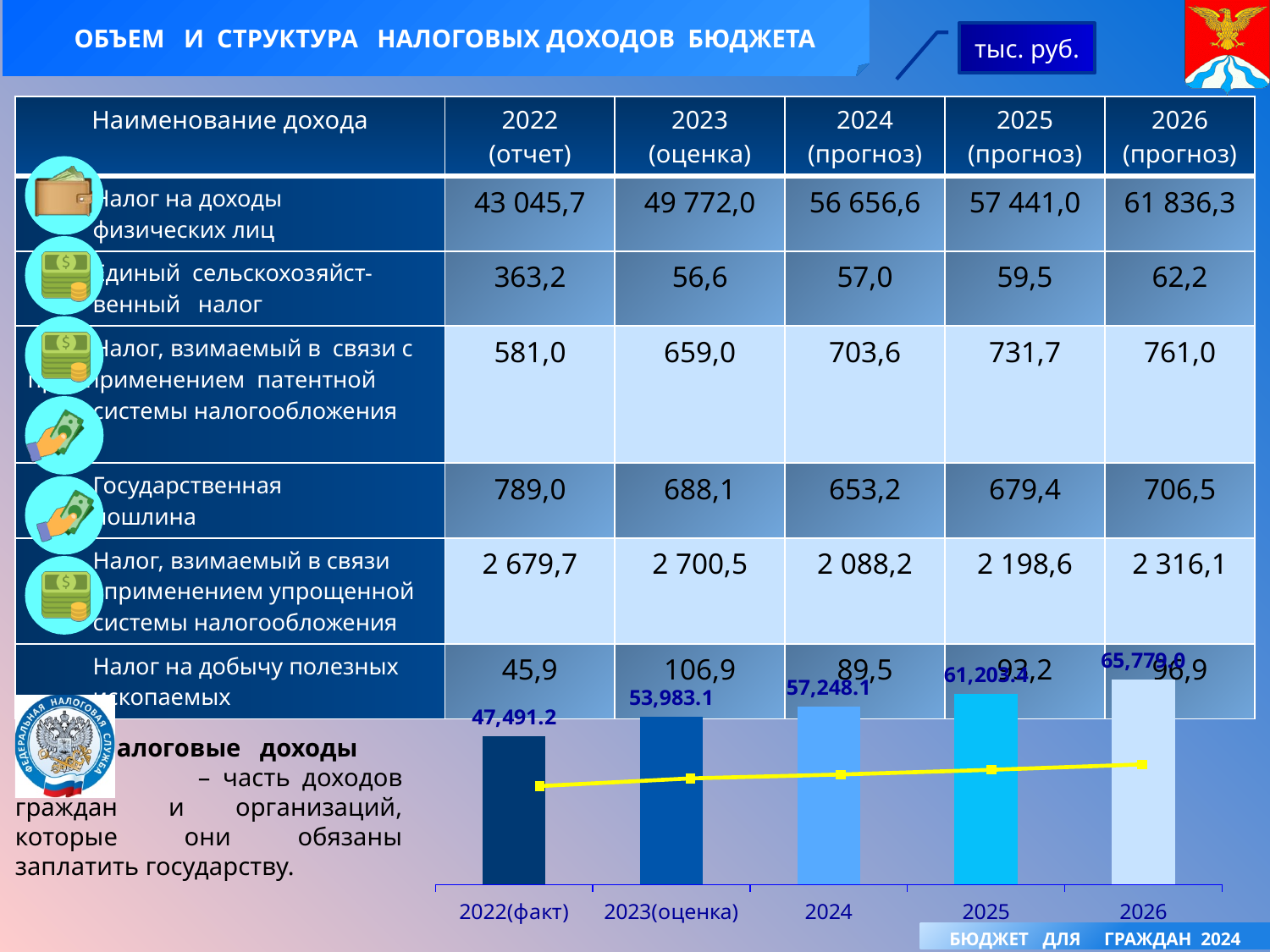
In the bar chart at the bottom of the slide, what is the value for 2023(оценка)? 53,983.1 In the bar chart at the bottom of the slide, which year has the shortest bar? 2022(факт) In the bar chart at the bottom of the slide, which is larger: the value for 2024 or the value for 2023(оценка)? 2024 What kind of chart is shown at the bottom of the slide? bar chart In the bar chart at the bottom of the slide, what is the difference between the values for 2024 and 2023(оценка)? 3,265.0 In the bar chart at the bottom of the slide, what is the difference between the values for 2023(оценка) and 2022(факт)? 6,491.9 In the bar chart at the bottom of the slide, what is the value for 2024? 57,248.1 In the bar chart at the bottom of the slide, do the bar values rise or fall from 2022(факт) to 2026? rise In the bar chart at the bottom of the slide, which year has the tallest bar? 2026 In the bar chart at the bottom of the slide, what is the value for 2022(факт)? 47,491.2 How many bars are shown in the bar chart at the bottom of the slide? 5 In the bar chart at the bottom of the slide, what is the label of the first category on the x axis? 2022(факт)